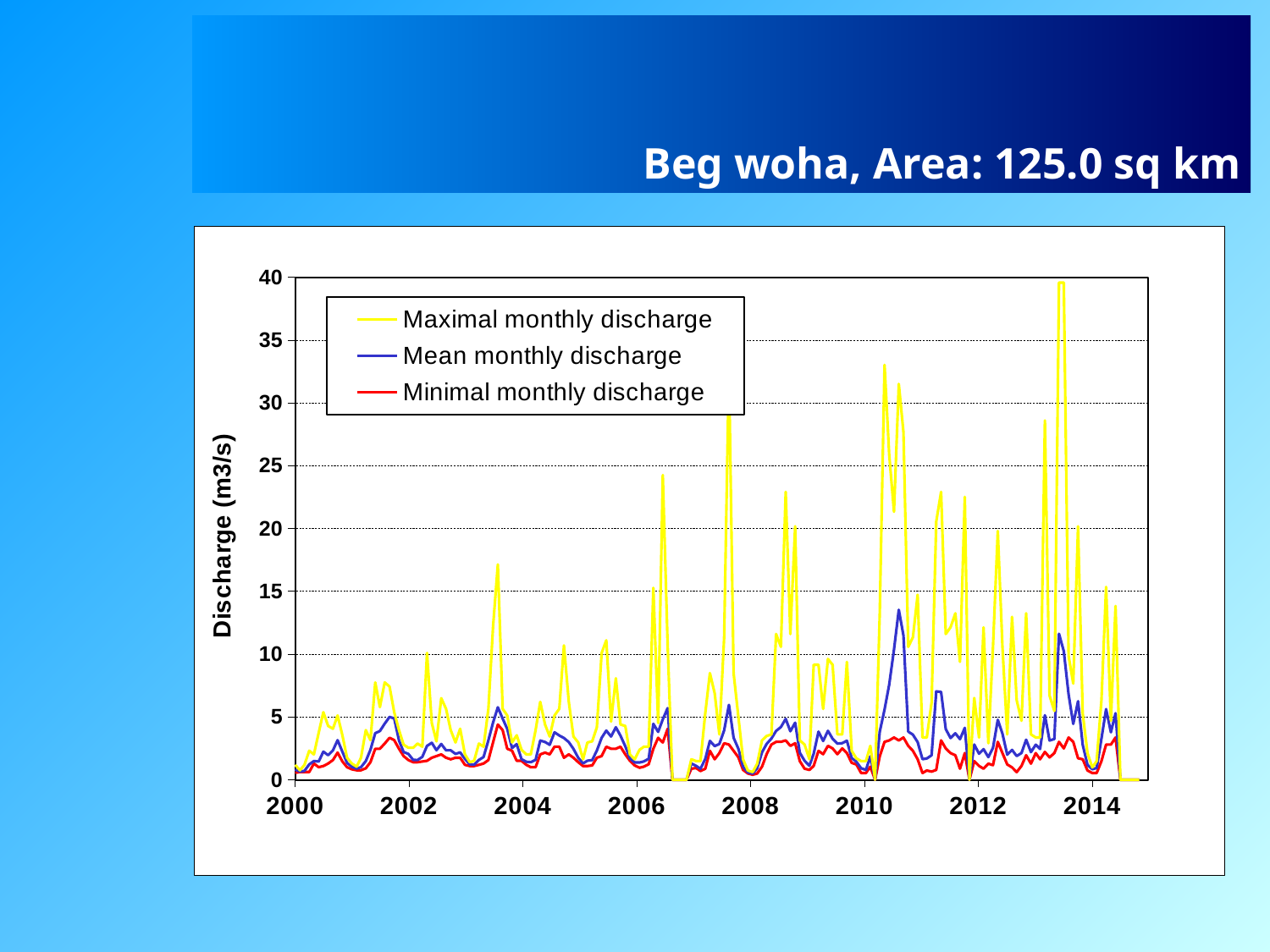
Which series stays lowest on the chart? Minimal monthly discharge Which colour is used for the Maximal monthly discharge series? yellow Which series reaches the highest values on the chart? Maximal monthly discharge What is the label on the vertical axis? Discharge (m3/s) Is the highest peak of the Maximal monthly discharge series greater or less than 35? greater How many year labels are shown on the horizontal axis? 8 Which series is larger around 2013: Mean monthly discharge or Minimal monthly discharge? Mean monthly discharge Is the highest value of the Minimal monthly discharge series greater or less than 10? less What is the highest value shown on the vertical axis? 40 How many series does the legend list? 3 Is the highest value of the Mean monthly discharge series greater or less than 15? less What kind of chart is shown on the slide? line chart